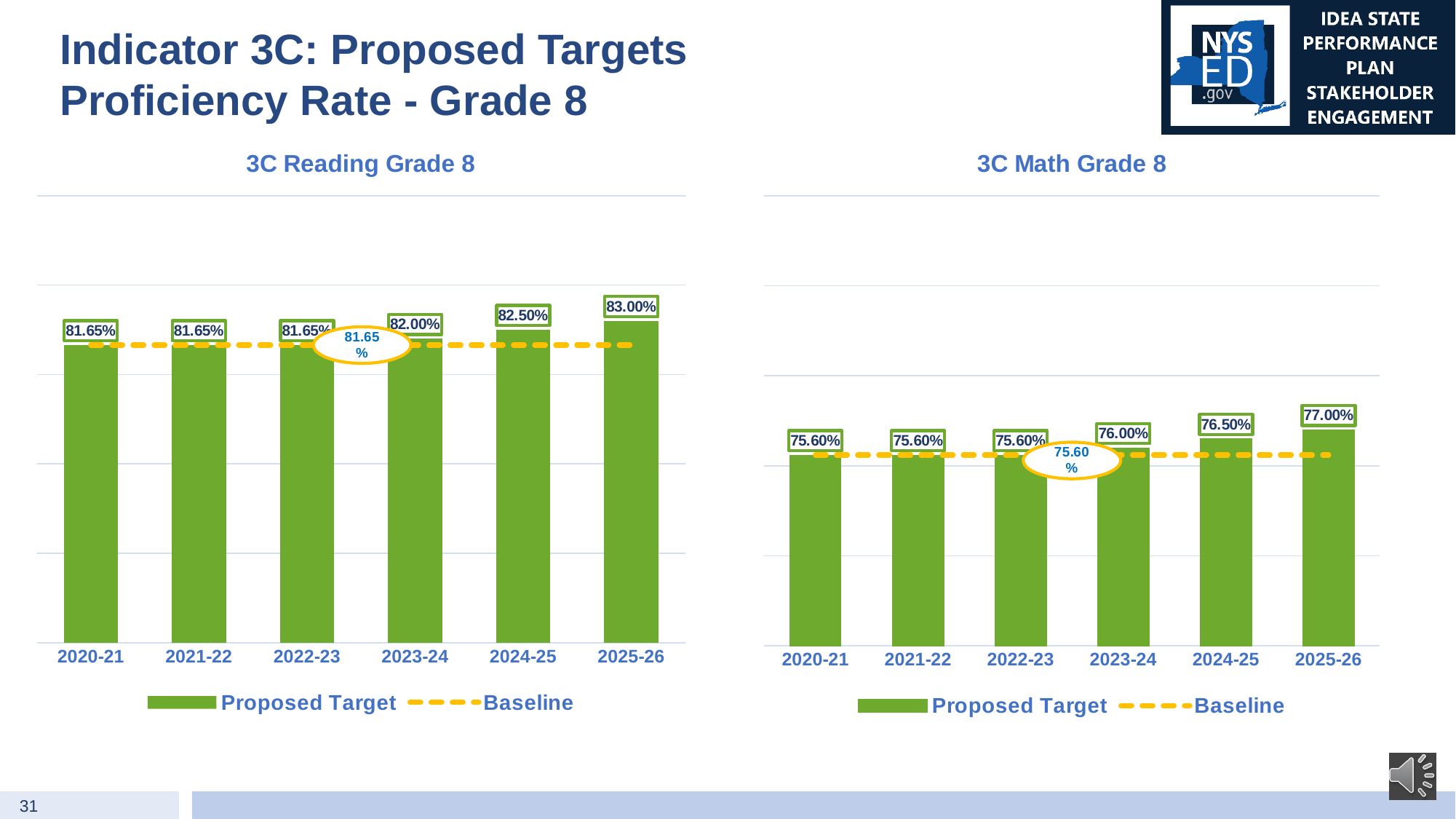
In the 3C Reading Grade 8 chart, what is the baseline value shown? 81.65% In the 3C Math Grade 8 chart, what is the baseline value shown? 75.60% In the 3C Math Grade 8 chart, do the proposed targets rise or fall from 2022-23 to 2025-26? rise In the 3C Reading Grade 8 chart, what is the proposed target for 2025-26? 83.00% How many years are shown on the x axis of the 3C Math Grade 8 chart? 6 In the 3C Reading Grade 8 chart, what is the difference between the proposed targets for 2025-26 and 2023-24? 1.00% In the 3C Math Grade 8 chart, what is the difference between the proposed targets for 2025-26 and 2020-21? 1.40% In the 3C Reading Grade 8 chart, is the proposed target for 2024-25 larger or smaller than the target for 2022-23? larger In the 3C Math Grade 8 chart, what is the proposed target for 2023-24? 76.00% In the 3C Math Grade 8 chart, which year has the highest proposed target? 2025-26 What kind of chart is the 3C Reading Grade 8 chart? combination bar and line chart How many series does the legend of the 3C Reading Grade 8 chart list? 2